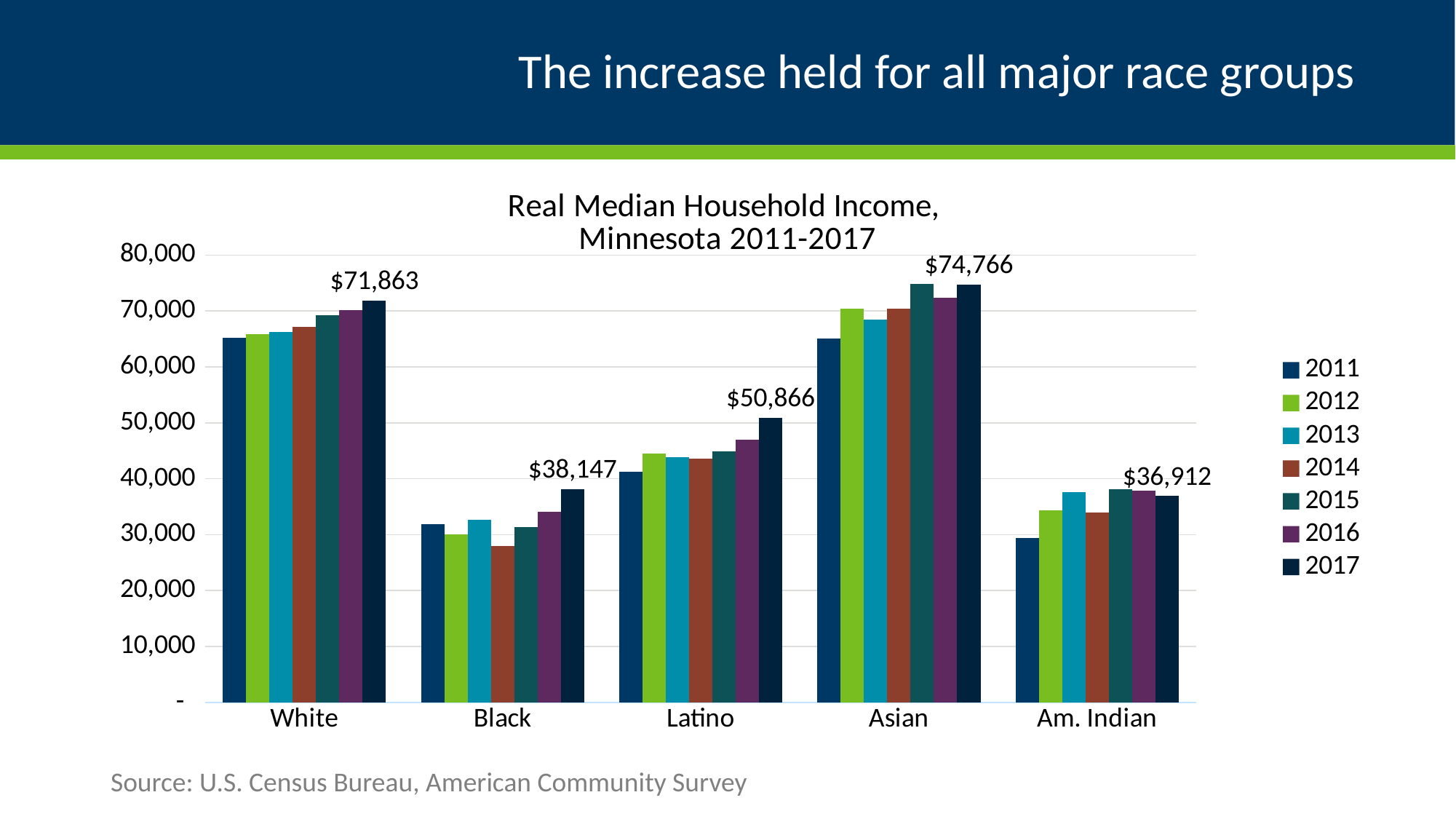
Is the 2011 value for White households greater or less than 60,000? greater What is the difference between the 2017 median household income for Asian households and White households? $2,903 Do the values for White households rise or fall from 2011 to 2017? rise Which is larger, the 2017 median household income for Black households or for Am. Indian households? Black Which race group has the highest 2017 real median household income? Asian What is the 2017 real median household income for Am. Indian households? $36,912 What is the 2017 real median household income for Black households? $38,147 Which race group has the lowest 2017 real median household income? Am. Indian What is the 2017 real median household income for Latino households? $50,866 How many race groups are shown on the x axis? 5 How many years does the legend list? 7 What is the 2017 real median household income for White households? $71,863